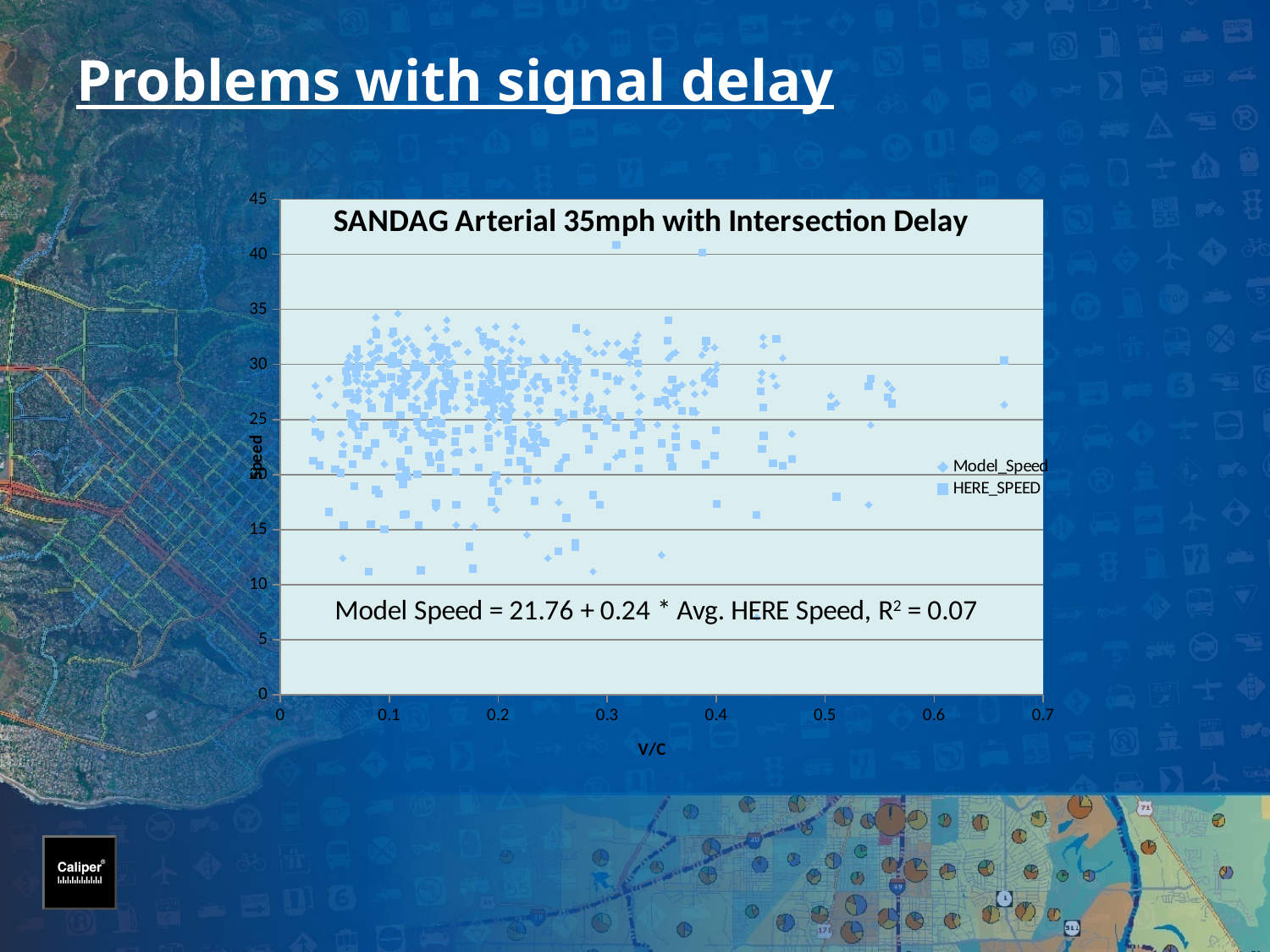
What is the title of the chart? SANDAG Arterial 35mph with Intersection Delay What is the maximum value shown on the chart's x axis? 0.7 What is the label of the chart's x axis? V/C What kind of chart is shown on the slide? Scatter chart How many series does the chart's legend list? 2 Is the lowest plotted speed value in the chart greater or less than 15? less Is the highest plotted speed value in the chart greater or less than 35? greater